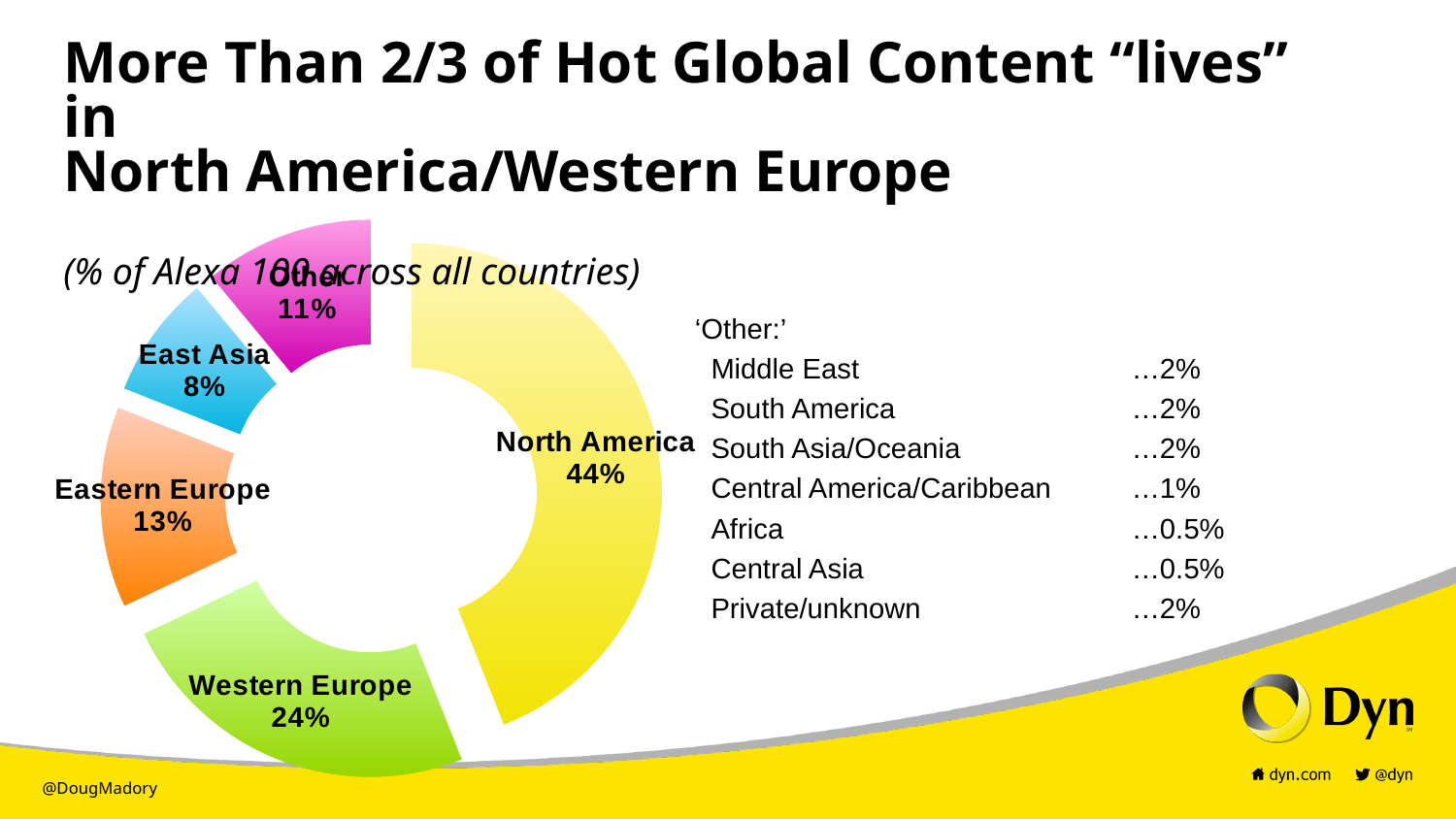
Which has a larger share, Eastern Europe or East Asia? Eastern Europe Which region has the largest share in the chart? North America How many percentage points larger is North America's share than Western Europe's? 20 How many segments does the chart have? 5 What percentage of the chart does North America account for? 44% What colour is the North America segment? Yellow What share does Eastern Europe have in the chart? 13% What is the value for East Asia? 8% What percentage is labelled as Other in the chart? 11% What kind of chart is shown on the slide? Doughnut chart What is the value shown for Western Europe? 24% Which region has the smallest share in the chart? East Asia